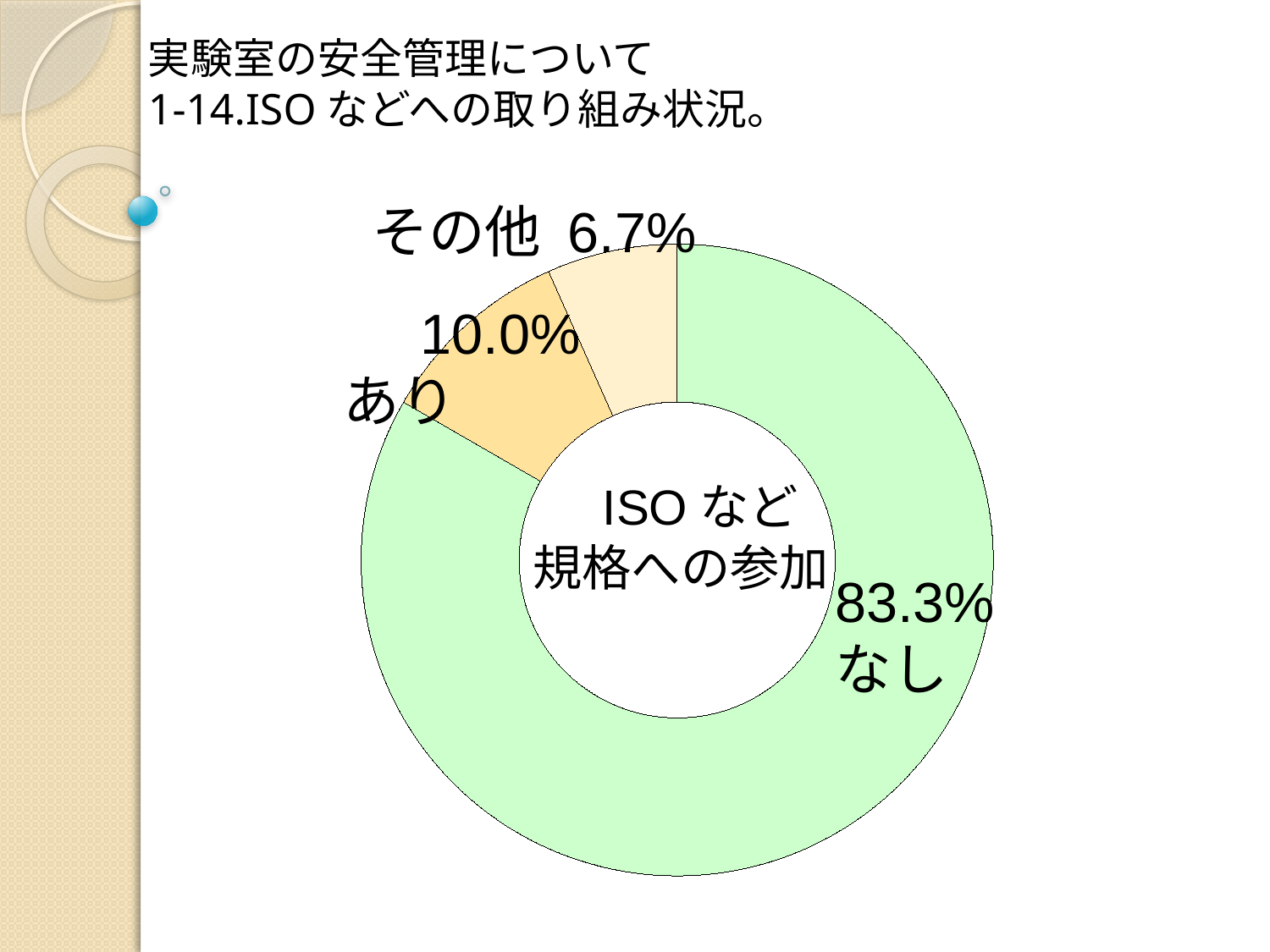
What text is written in the centre of the doughnut chart? ISO など規格への参加 What share of the doughnut chart is labelled あり? 10.0% What is the difference in percentage points between なし and あり? 73.3 What share of the doughnut chart is labelled その他? 6.7% What share of the doughnut chart is labelled なし? 83.3% What is the difference in percentage points between あり and その他? 3.3 Which category has the smallest share in the chart? その他 Which is larger, the share for あり or the share for その他? あり What colour is the segment labelled なし? light green Which category has the largest share in the chart? なし What kind of chart is shown on the slide? doughnut chart How many categories are shown in the chart? 3